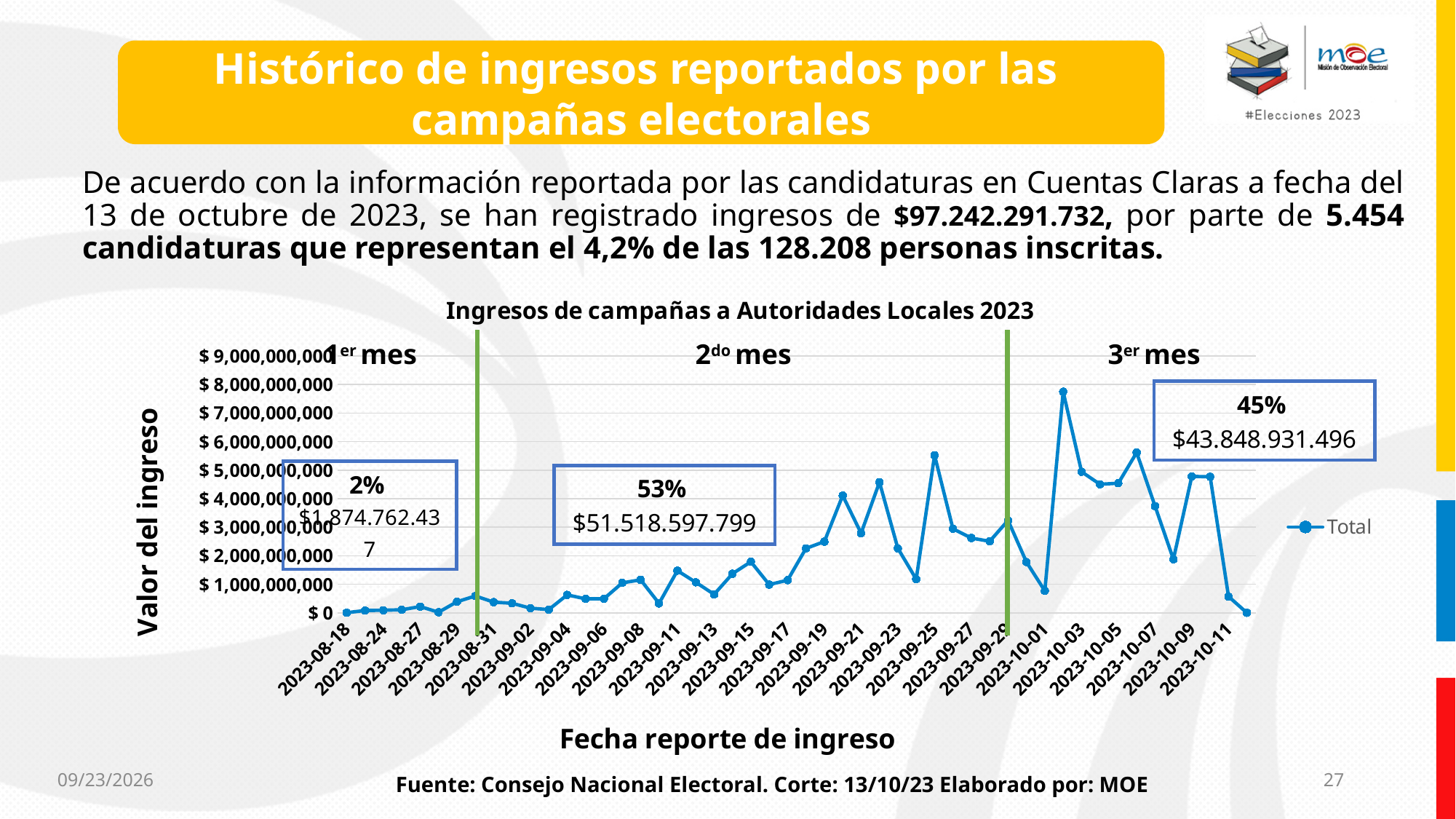
Is the highest point on the Total line greater or less than $7,000,000,000? greater What kind of chart is shown on the slide? Line chart What percentage is shown in the annotation for the 1er mes? 2% What is the difference between the income annotated for the 2do mes and the 3er mes? $7.669.666.303 What is the name of the series shown in the chart legend? Total What percentage of income is attributed to the 2do mes in the chart annotation? 53% Is the value for 2023-08-18 greater or less than $1,000,000,000? less Which month period has the lowest share of income according to the annotations? 1er mes What is the title of the chart? Ingresos de campañas a Autoridades Locales 2023 How many series does the chart legend list? 1 What income value is shown in the annotation for the 3er mes? $43.848.931.496 Which month period has the highest share of income according to the annotations? 2do mes